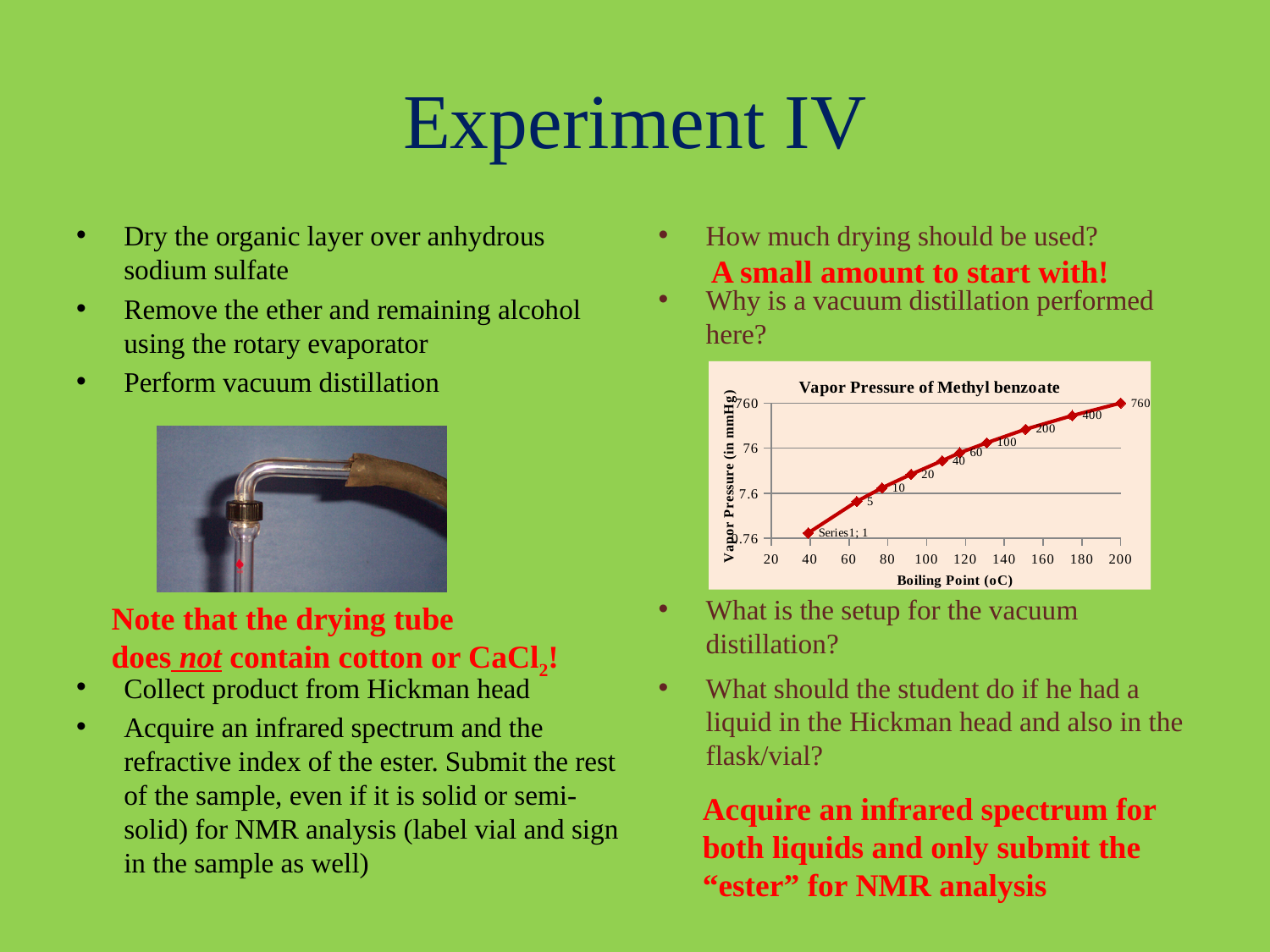
Is the vapor pressure at a boiling point of 100 oC greater or less than 7.6? greater Is the vapor pressure at a boiling point of 40 oC greater or less than 7.6? less What kind of chart is shown on the slide? line chart Does the vapor pressure rise or fall as the boiling point increases along the x axis? rise What is the title of the chart? Vapor Pressure of Methyl benzoate What is the highest vapor pressure value labelled on the chart? 760 What is the data label on the rightmost point of the chart? 760 What is the lowest vapor pressure value labelled on the chart? 1 How many data points are plotted on the chart? 10 Which is larger, the data label 400 or the data label 200 on the chart? 400 What is the difference between the two highest labelled vapor pressure values on the chart? 360 What is the label of the x axis of the chart? Boiling Point (oC)